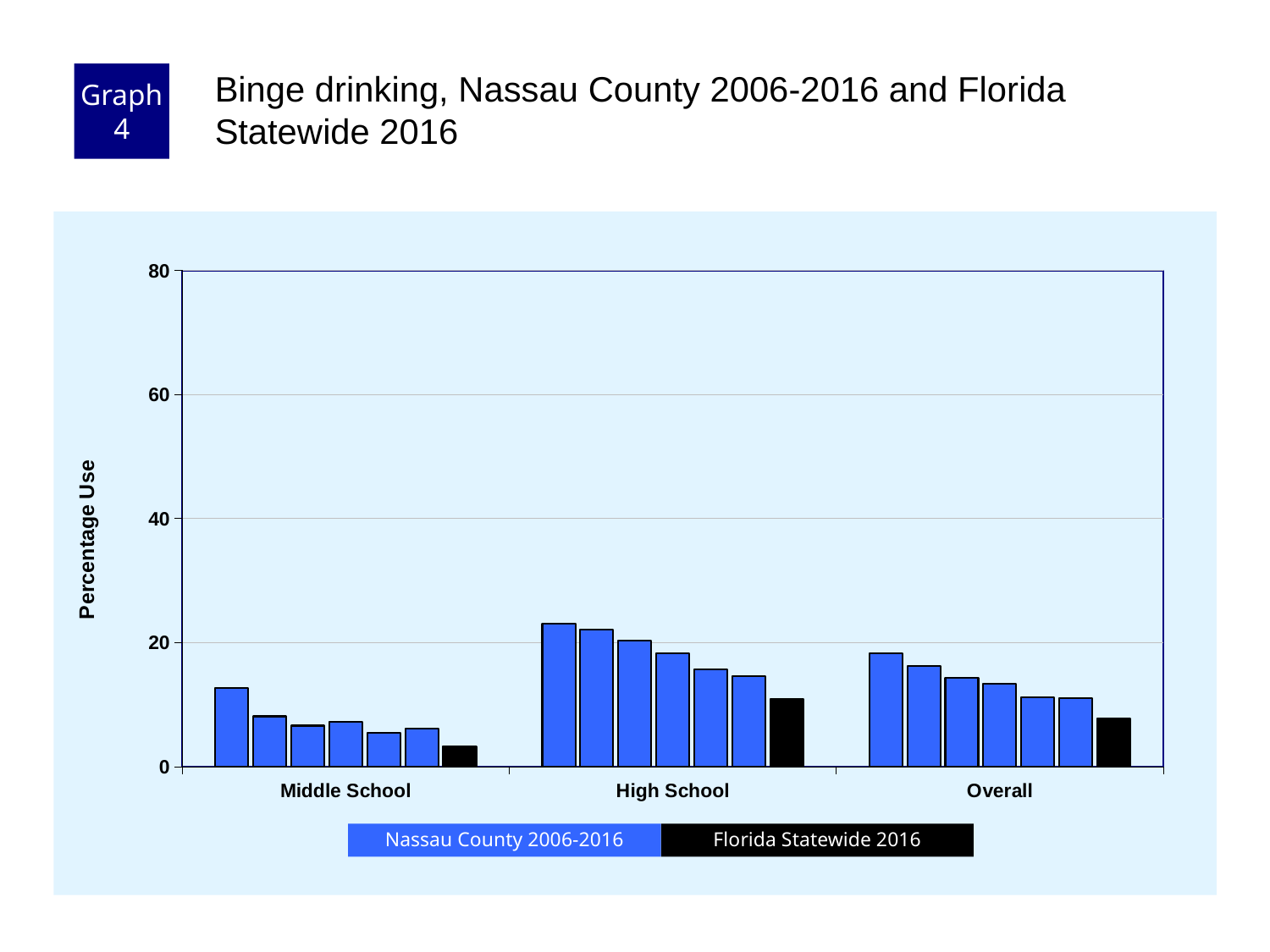
Is the Florida Statewide 2016 bar for Overall greater or less than 20? less Within the High School group, do the Nassau County 2006-2016 bars generally rise or fall from left to right? fall What colour represents Florida Statewide 2016 in the legend? black How many series does the legend list? 2 Which category has the lowest bars overall? Middle School Which category has the highest bars overall? High School Is the Florida Statewide 2016 bar for Middle School greater or less than 20? less Which is larger for High School: the Florida Statewide 2016 bar or the first Nassau County 2006-2016 bar? the first Nassau County 2006-2016 bar What kind of chart is shown on the slide? bar chart How many categories are shown on the x axis? 3 Is the tallest Nassau County bar for High School greater or less than 20? greater What is the label on the y axis? Percentage Use